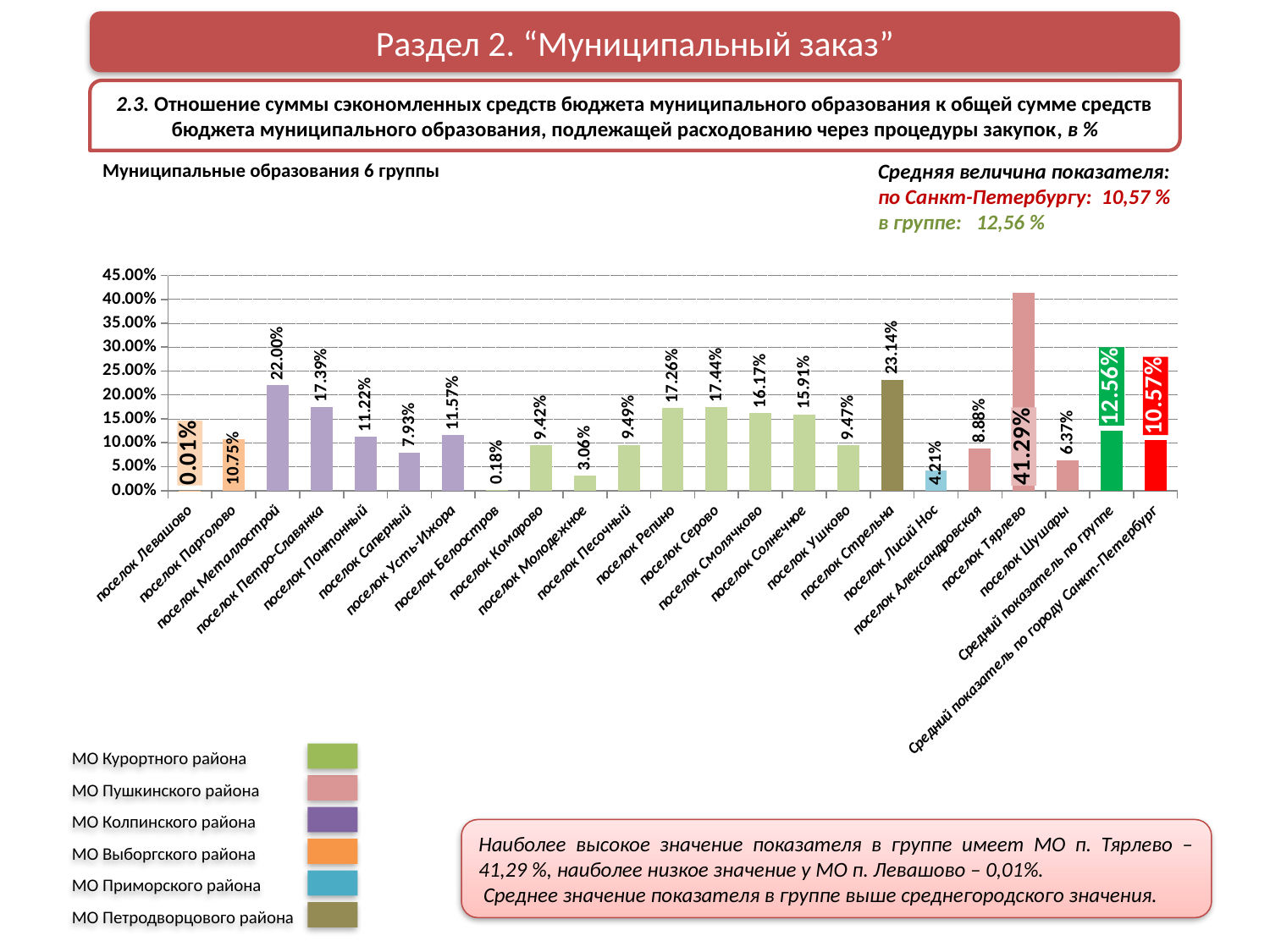
What is the value shown for Средний показатель по группе? 12.56% What kind of chart is shown on the slide? bar chart Is the value for поселок Тярлево greater or less than 40.00%? greater Which category has the highest value in the chart? поселок Тярлево How many categories are shown on the x axis of the chart? 23 Which is larger, the value for поселок Репино or the value for поселок Серово? поселок Серово What is the difference between Средний показатель по группе and Средний показатель по городу Санкт-Петербург? 1.99% What is the value for поселок Металлострой? 22.00% What is the difference between the values for поселок Тярлево and поселок Левашово? 41.28% How many district groups does the legend below the chart list? 6 What is the value for поселок Стрельна? 23.14% Which category has the lowest value in the chart? поселок Левашово